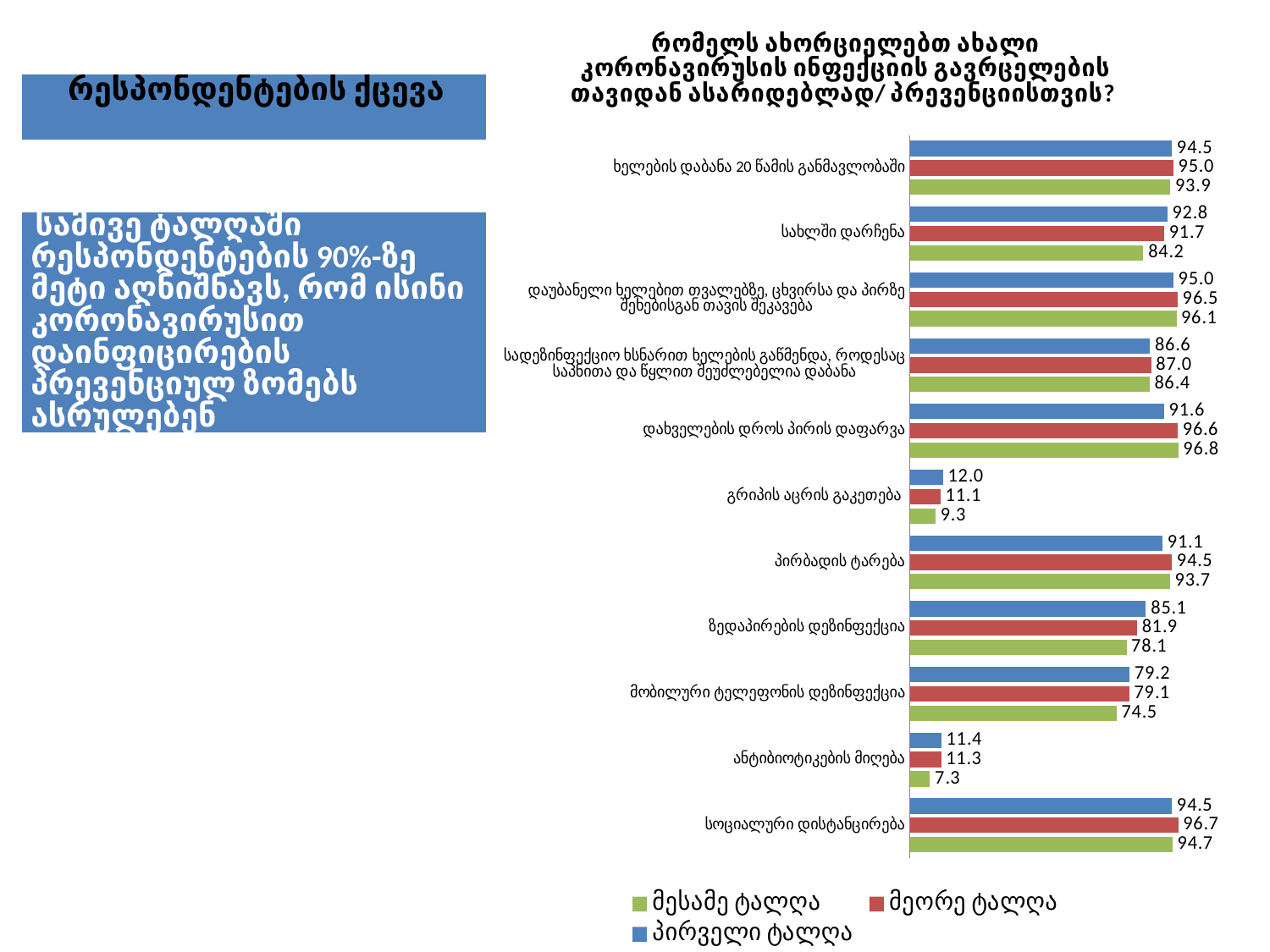
What is the difference between the 'მეორე ტალღა' and 'მესამე ტალღა' values for 'მობილური ტელეფონის დეზინფექცია'? 4.6 How many series does the chart legend list? 3 What kind of chart is shown on the slide? bar chart What is the value for 'გრიპის აცრის გაკეთება' in the 'პირველი ტალღა' series? 12.0 What is the value for 'სოციალური დისტანცირება' in the 'მეორე ტალღა' series? 96.7 How many categories are plotted in the chart? 11 Which category has the highest value in the 'პირველი ტალღა' series? დაუბანელი ხელებით თვალებზე, ცხვირსა და პირზე შეხებისგან თავის შეკავება What is the value for 'სახლში დარჩენა' in the 'მესამე ტალღა' series? 84.2 Which category has the lowest value in the 'მესამე ტალღა' series? ანტიბიოტიკების მიღება What is the difference between the 'პირველი ტალღა' and 'მესამე ტალღა' values for 'სახლში დარჩენა'? 8.6 For 'ზედაპირების დეზინფექცია', which series has the larger value: 'პირველი ტალღა' or 'მესამე ტალღა'? პირველი ტალღა Which series is shown in green in the chart? მესამე ტალღა